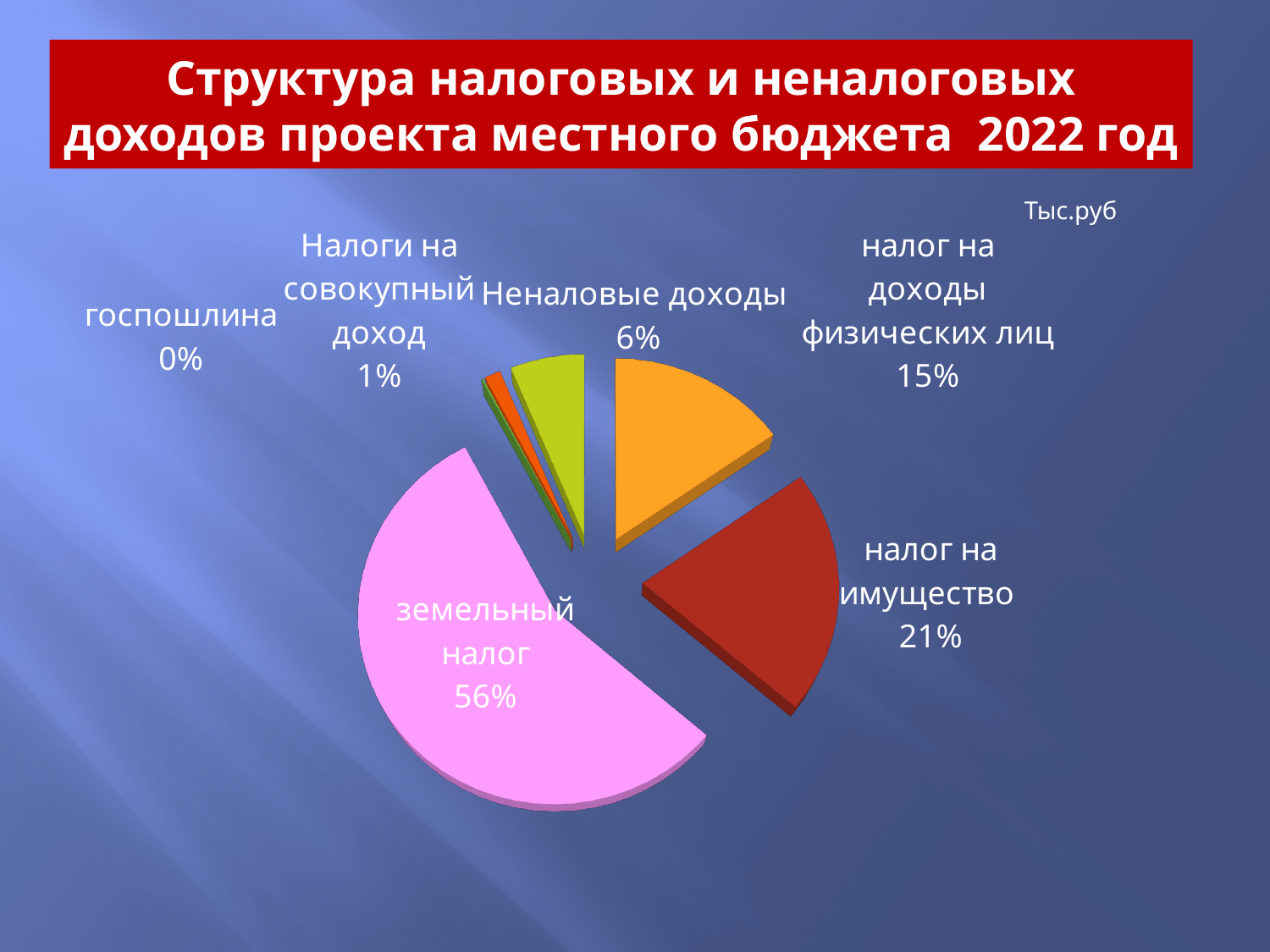
What share of the pie does земельный налог have? 56% Which is larger: the share of Неналовые доходы or the share of налог на доходы физических лиц? налог на доходы физических лиц What kind of chart is shown on the slide? pie chart What share of the pie does налог на доходы физических лиц have? 15% How many categories are shown in the pie chart? 6 Which category has the smallest share of the pie? госпошлина What is the difference between the shares of налог на имущество and налог на доходы физических лиц? 6% Which category has the largest share of the pie? земельный налог What share of the pie does госпошлина have? 0%